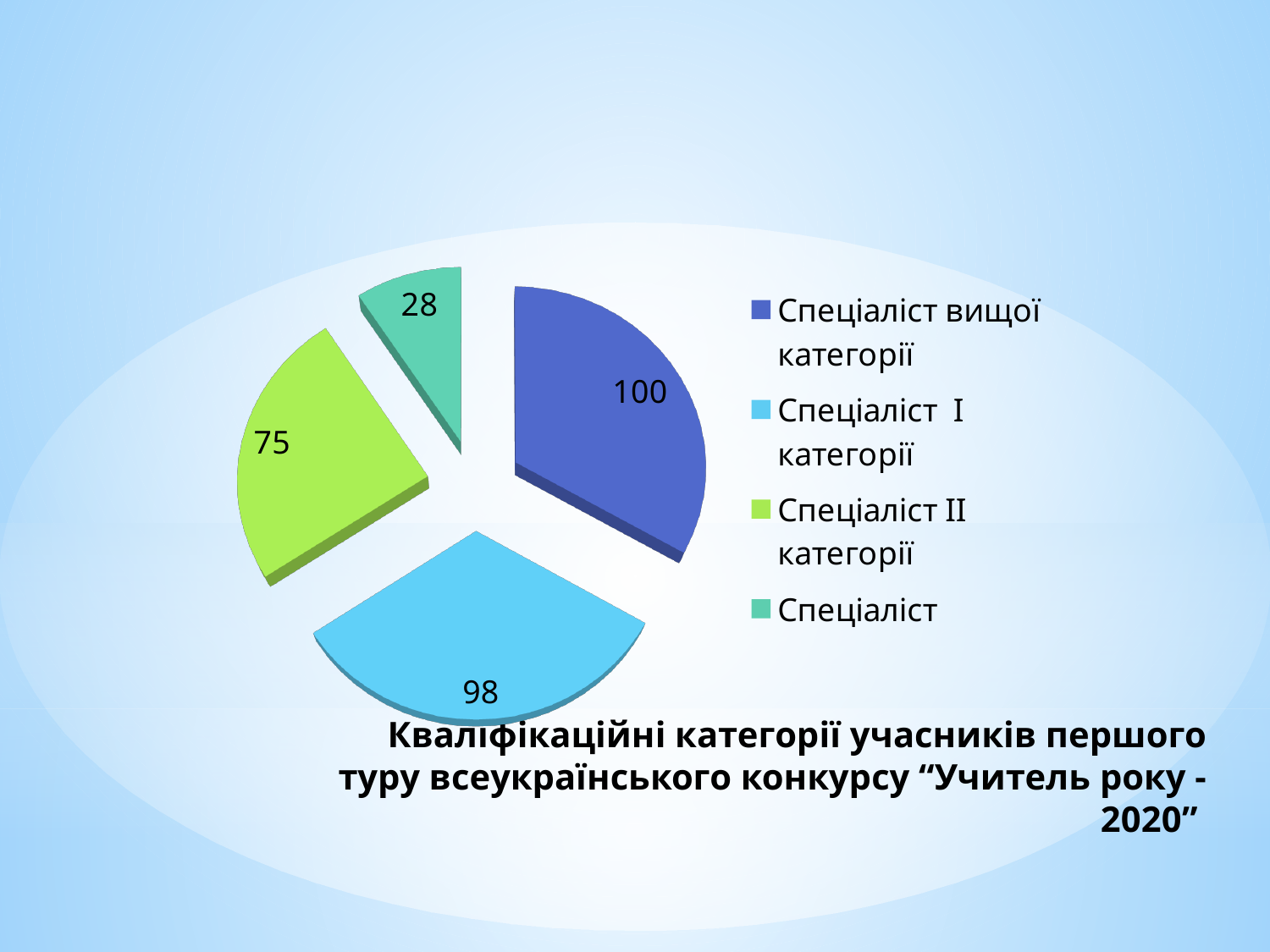
What is the value for Спеціаліст I категорії? 98 What is the total of all the slices in the pie chart? 301 How many categories does the pie chart show? 4 Which is larger: the value for Спеціаліст I категорії or the value for Спеціаліст II категорії? Спеціаліст I категорії What is the value for Спеціаліст вищої категорії? 100 What is the value for Спеціаліст? 28 Which category has the largest slice of the pie? Спеціаліст вищої категорії What type of chart is shown on the slide? pie chart What is the difference between the values for Спеціаліст II категорії and Спеціаліст? 47 What is the value for Спеціаліст II категорії? 75 Which category has the smallest slice of the pie? Спеціаліст What colour is the slice for Спеціаліст II категорії? green